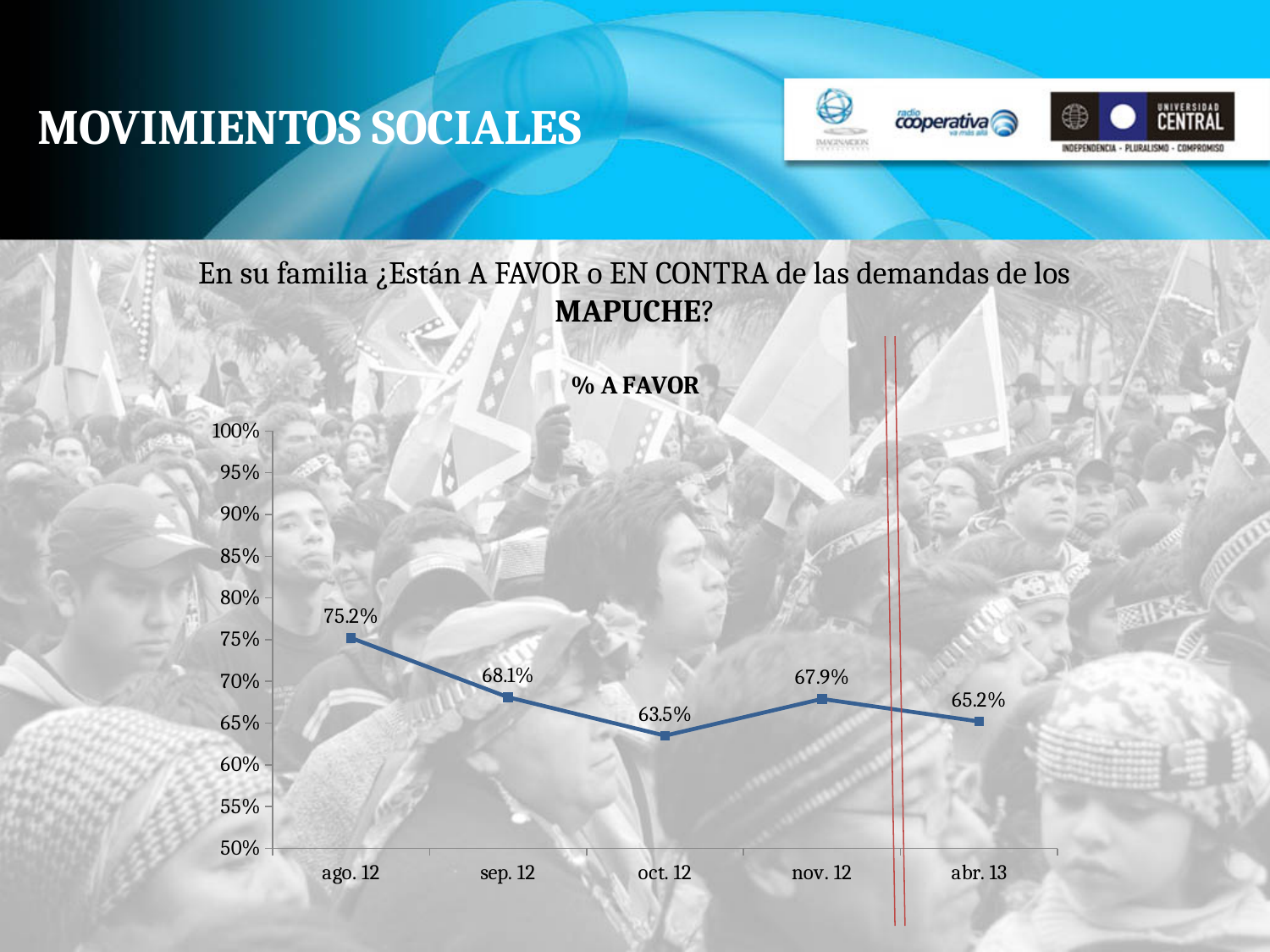
How many data points are plotted on the chart? 5 What is the % A FAVOR value for oct. 12? 63.5% What is the title of the chart? % A FAVOR Does the % A FAVOR value rise or fall from ago. 12 to oct. 12? Fall What is the % A FAVOR value for ago. 12? 75.2% What is the difference between the % A FAVOR values for ago. 12 and abr. 13? 10 percentage points Is the value for nov. 12 greater or less than 70%? less What kind of chart is shown on the slide? Line chart Which is larger, the % A FAVOR value for sep. 12 or nov. 12? sep. 12 Which month has the lowest % A FAVOR value? oct. 12 Which month has the highest % A FAVOR value? ago. 12 What is the % A FAVOR value for abr. 13? 65.2%